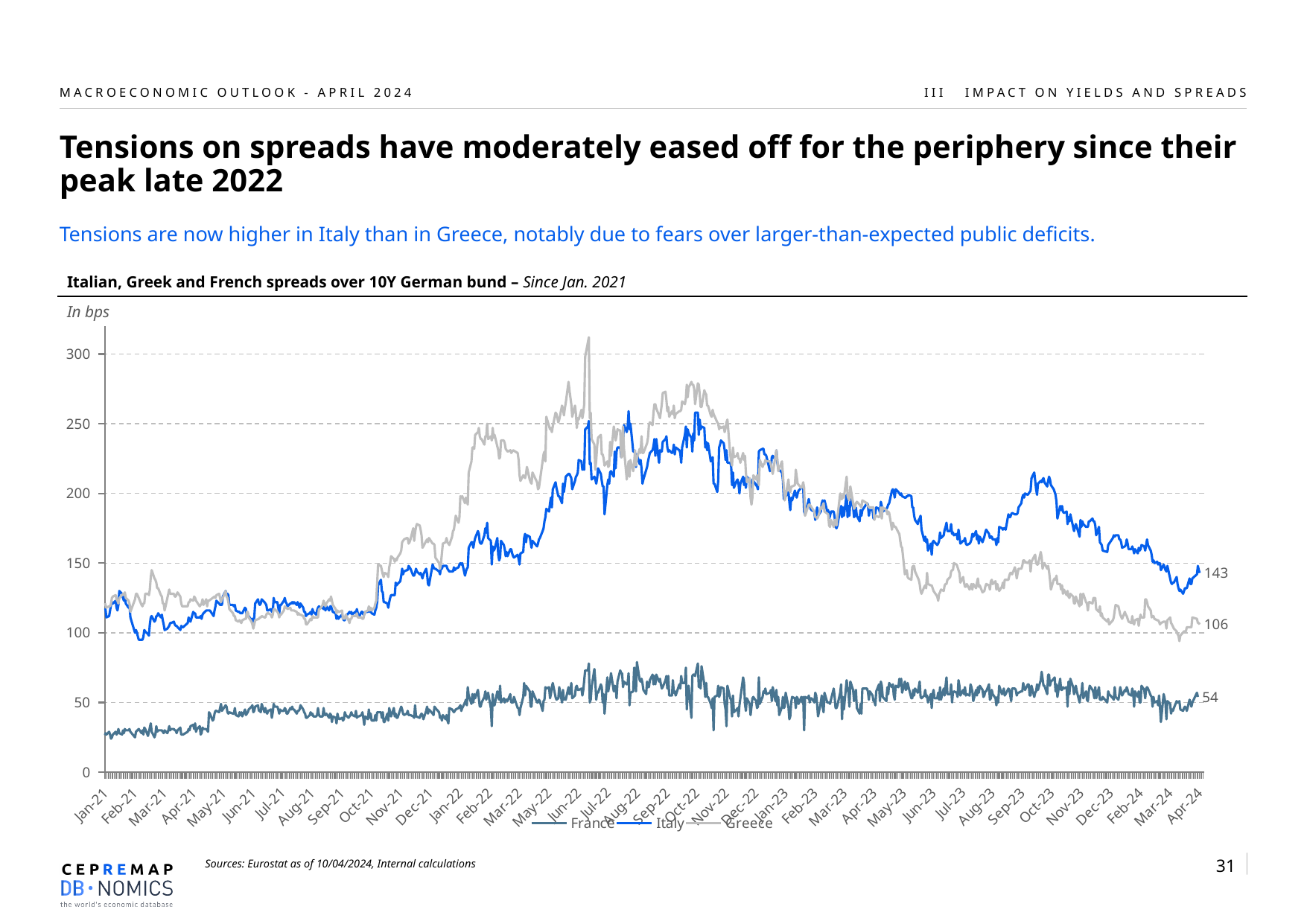
What kind of chart is shown on the slide? Line chart How many series does the legend list? 3 By how much does the latest Italian spread (143) exceed the latest Greek spread (106)? 37 What is the latest value shown for Greece at the right end of the chart? 106 At the right end of the chart, which is larger: the Italian spread or the Greek spread? Italy Is the value for France in Jan-21 greater or less than 50? less Is the peak value of the Greece series greater or less than 300? greater Which series has the highest value at the right end of the chart? Italy What is the latest value shown for France at the right end of the chart? 54 What is the difference between the latest Italian spread (143) and the latest French spread (54)? 89 What is the latest value shown for Italy at the right end of the chart? 143 In what unit are the values on the chart expressed? bps